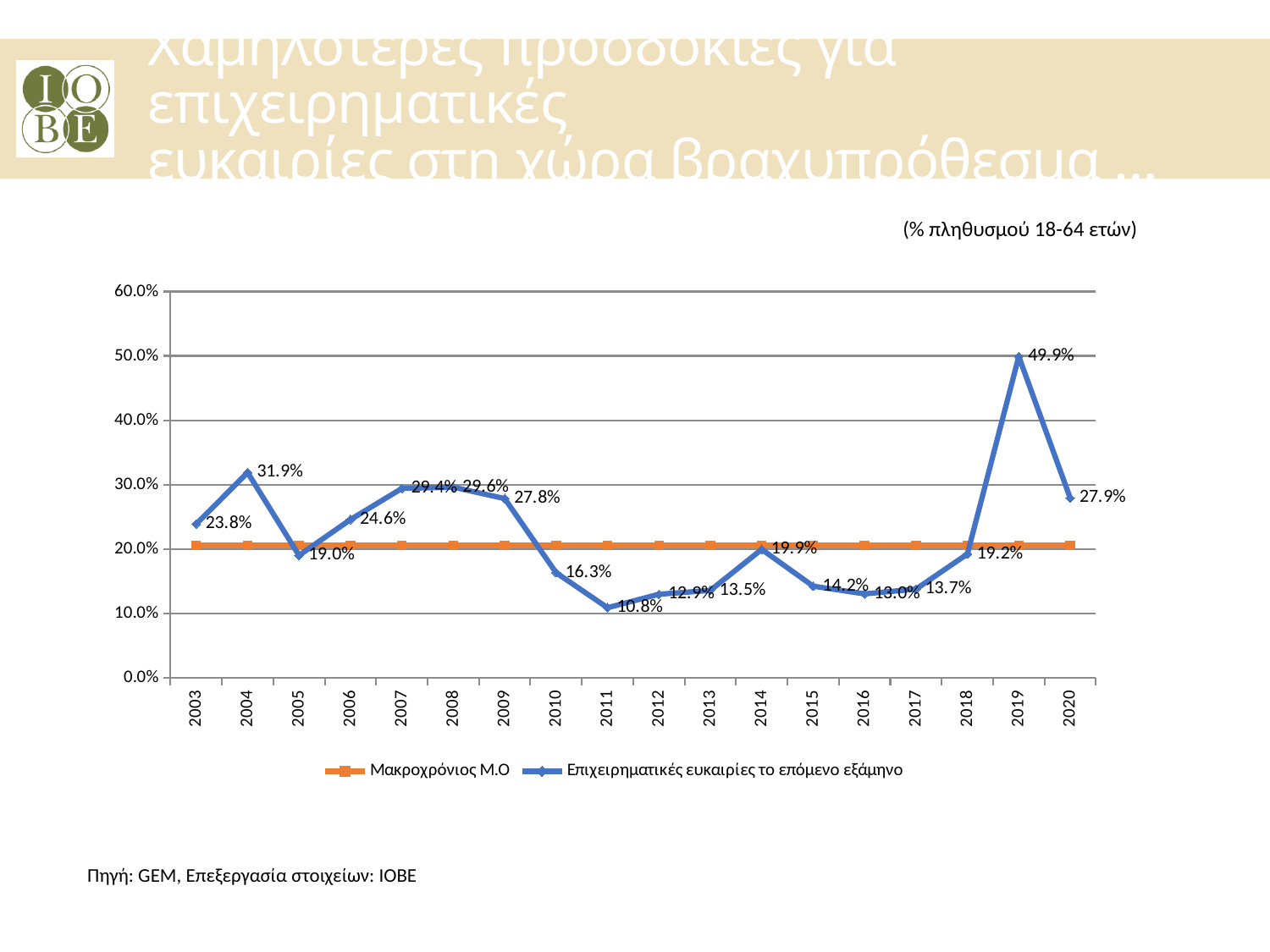
What is the value of 'Επιχειρηματικές ευκαιρίες το επόμενο εξάμηνο' for 2011? 10.8% In which year is 'Επιχειρηματικές ευκαιρίες το επόμενο εξάμηνο' lowest? 2011 In which year is 'Επιχειρηματικές ευκαιρίες το επόμενο εξάμηνο' highest? 2019 What is the value of 'Επιχειρηματικές ευκαιρίες το επόμενο εξάμηνο' for 2020? 27.9% How many years are shown on the x axis? 18 Does 'Επιχειρηματικές ευκαιρίες το επόμενο εξάμηνο' rise or fall from 2019 to 2020? fall What is the difference between the 2019 and 2020 values of 'Επιχειρηματικές ευκαιρίες το επόμενο εξάμηνο'? 22.0% Which year has a higher value for 'Επιχειρηματικές ευκαιρίες το επόμενο εξάμηνο', 2004 or 2006? 2004 Is the value of 'Μακροχρόνιος Μ.Ο' greater or less than 30.0%? less What is the value of 'Επιχειρηματικές ευκαιρίες το επόμενο εξάμηνο' for 2019? 49.9% What type of chart is shown on the slide? line chart How many series does the legend list? 2